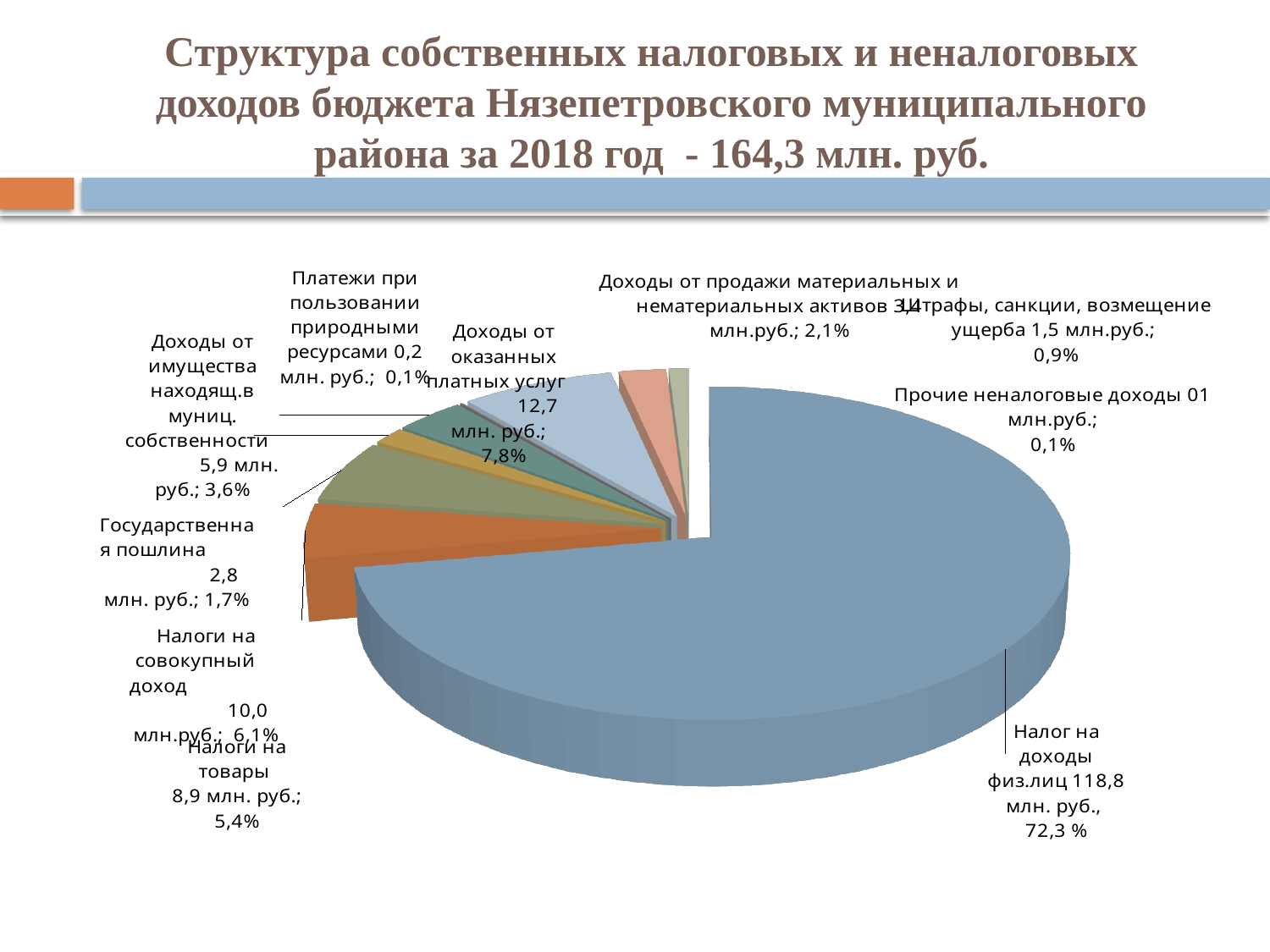
What is the value in млн. руб. for Государственная пошлина? 2,8 млн. руб. What is the difference in млн. руб. between Доходы от оказанных платных услуг and Налоги на товары? 3,8 млн. руб. What kind of chart is shown on the slide? Pie chart How many categories (slices) does the pie chart have? 10 What is the value in млн. руб. for Доходы от оказанных платных услуг? 12,7 млн. руб. According to the slide title, what is the total of own tax and non-tax revenues of the budget for 2018? 164,3 млн. руб. What share of the pie does Налог на доходы физ.лиц account for? 72,3 % What share of the pie does Налоги на совокупный доход account for? 6,1% Which is larger: Налоги на совокупный доход or Налоги на товары? Налоги на совокупный доход What share of the pie does Штрафы, санкции, возмещение ущерба account for? 0,9% What is the value in млн. руб. for Налог на доходы физ.лиц? 118,8 млн. руб. Which category has the largest share of the pie? Налог на доходы физ.лиц